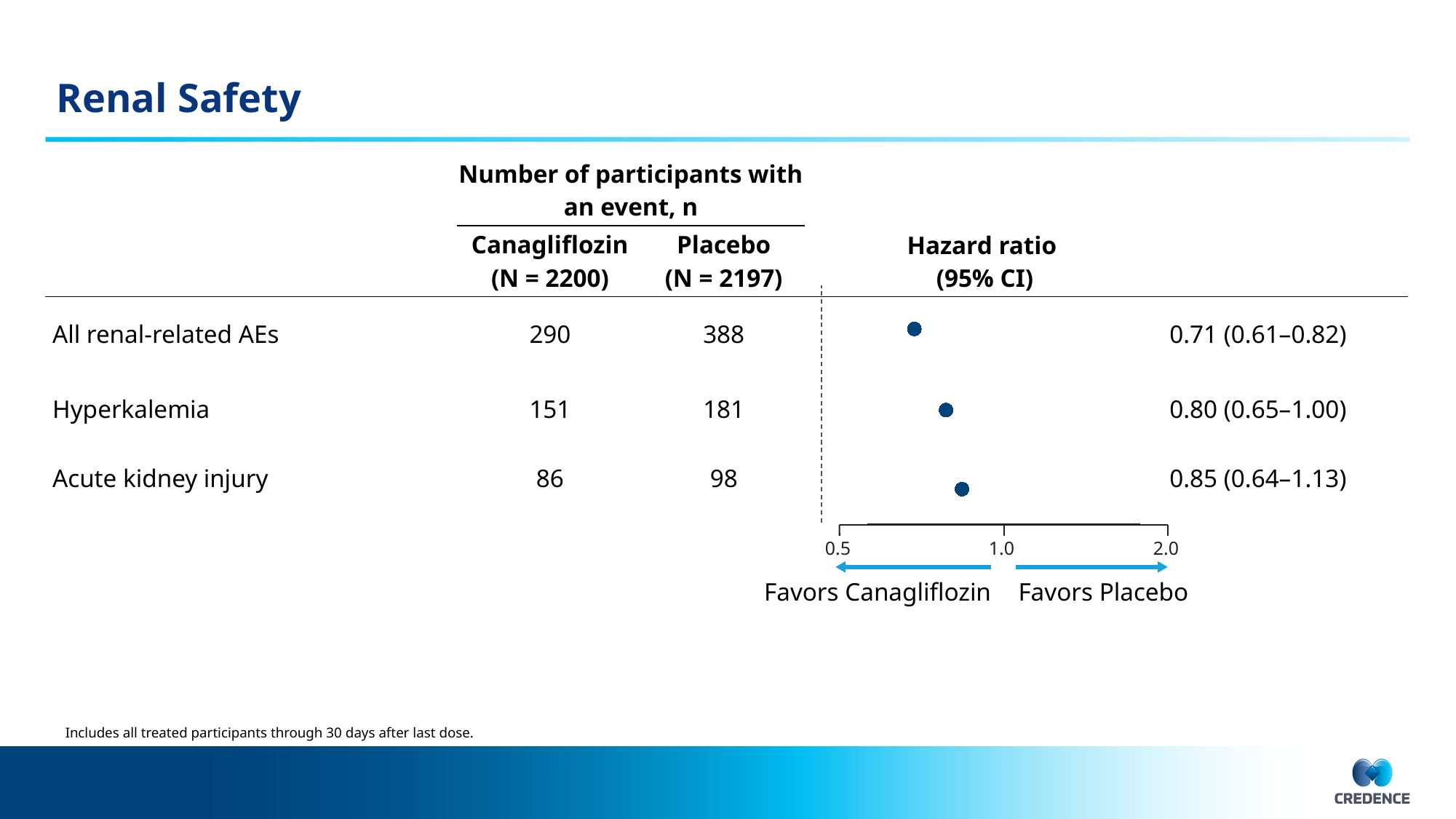
What is the hazard ratio for Hyperkalemia? 0.80 What is the hazard ratio for Acute kidney injury? 0.85 What is the difference between the hazard ratios for Acute kidney injury and All renal-related AEs? 0.14 How many participants in the Placebo group had an event for Hyperkalemia? 181 What is the hazard ratio for All renal-related AEs? 0.71 Which outcome has the lowest hazard ratio? All renal-related AEs Is the hazard ratio for Hyperkalemia greater or less than 1.0? less How many outcomes are plotted in the forest plot? 3 What does the left side of the hazard ratio axis favor? Favors Canagliflozin Which has a larger hazard ratio, Hyperkalemia or All renal-related AEs? Hyperkalemia What is the 95% CI for the hazard ratio of Acute kidney injury? 0.64–1.13 Which outcome has the highest hazard ratio? Acute kidney injury